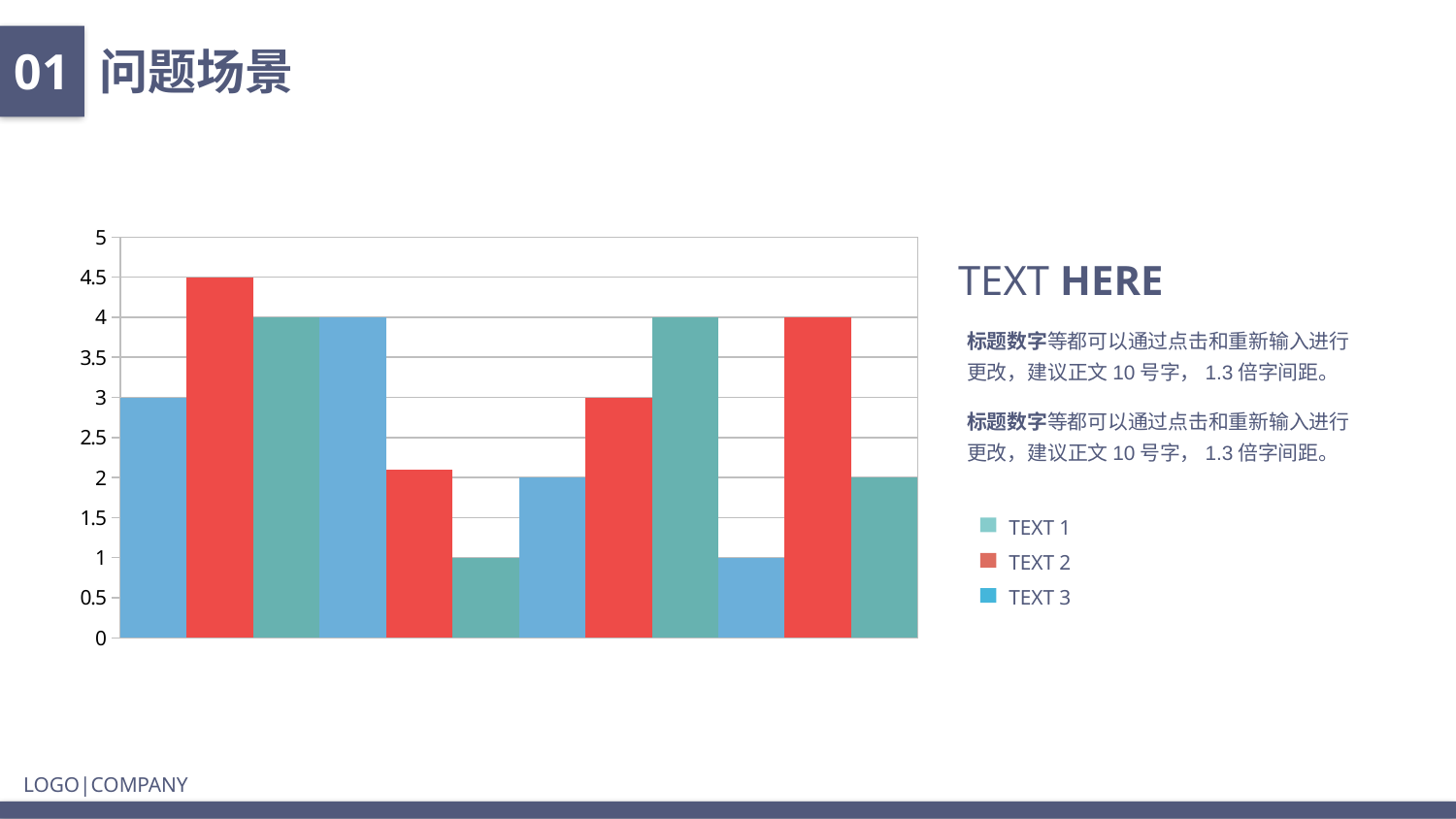
Which is larger, the second bar from the left or the first bar from the left? the second bar Is the value of the first bar from the left greater or less than 2? greater What is the value of the tallest bar in the chart? 4.5 Is the value of the second bar from the left greater or less than 4? greater Is the value of the last bar on the right greater or less than 3? less What is the highest value shown on the vertical axis? 5 What is the value of the shortest bars in the chart? 1 How many series does the legend list? 3 How many bars are plotted in the chart? 12 What kind of chart is shown on the slide? bar chart What are the three entries listed in the legend? TEXT 1, TEXT 2, TEXT 3